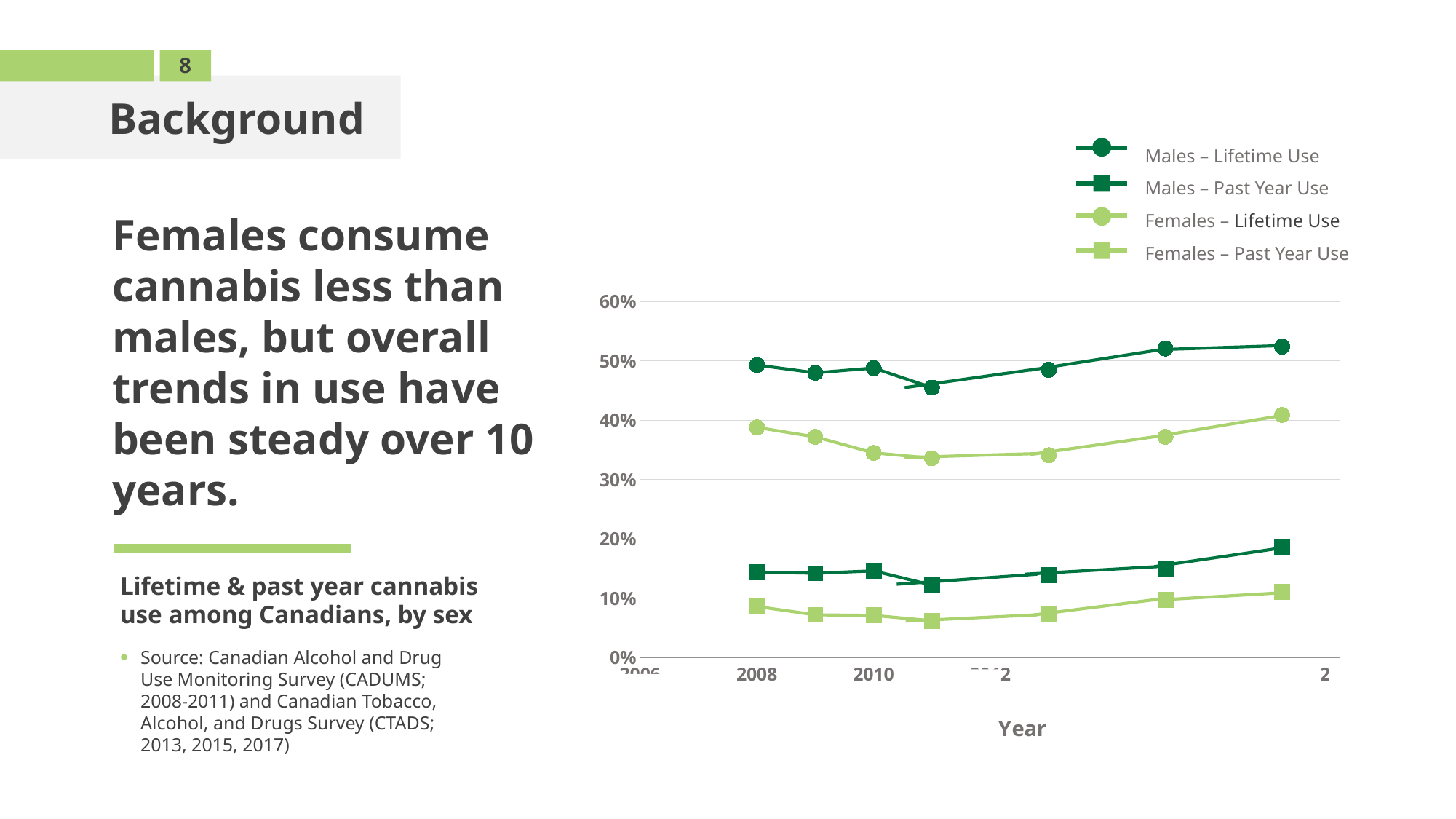
How many series does the chart legend list? 4 Is the value for Males – Lifetime Use in 2008 greater or less than 40%? greater What is the title of the x axis? Year Is the value for Females – Lifetime Use in 2017 greater or less than 30%? greater Does the Females – Lifetime Use series rise or fall between 2011 and 2017? Rise Is the value for Females – Past Year Use in 2008 greater or less than 10%? less In 2010, which is larger: Males – Lifetime Use or Females – Lifetime Use? Males – Lifetime Use How many data points are plotted for the Males – Lifetime Use series? 7 What kind of chart is shown on the slide? Line chart In which year is the Females – Lifetime Use series at its highest? 2017 In which year is the Males – Lifetime Use series at its lowest? 2011